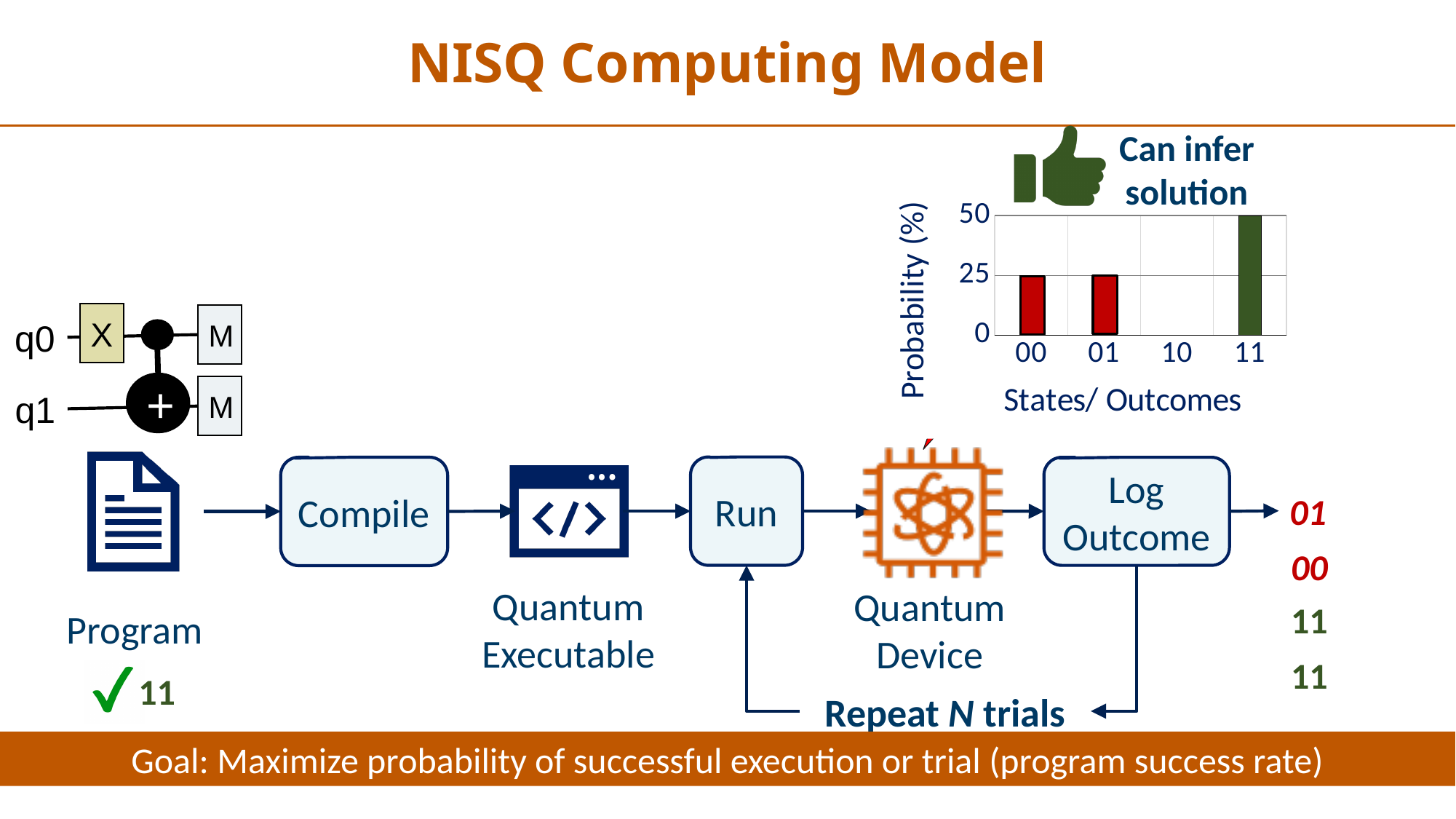
What is the probability (%) for state 01? 25 What is the label of the chart's y axis? Probability (%) What is the difference in probability (%) between state 11 and state 00? 25 What is the probability (%) for state 10? 0 Which state has the highest probability? 11 What is the label of the chart's x axis? States/ Outcomes Which has a higher probability, state 11 or state 01? 11 What kind of chart is shown on the slide? bar chart What is the probability (%) for state 11? 50 Which state has the lowest probability? 10 How many states are shown on the x axis of the chart? 4 What is the probability (%) for state 00? 25